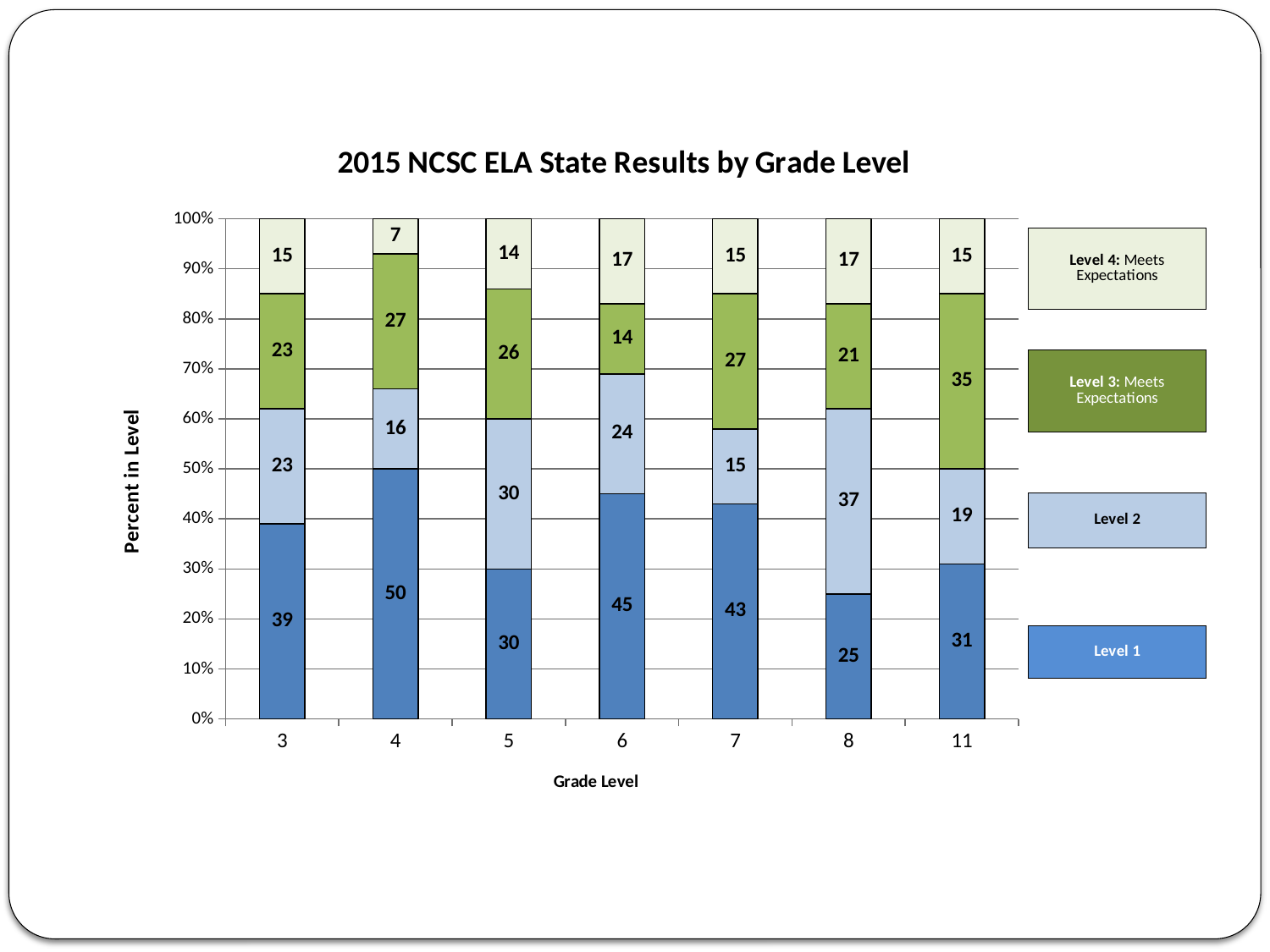
What is the title of the chart? 2015 NCSC ELA State Results by Grade Level What is the Level 1 value for grade 4? 50 Which is larger, the Level 2 value for grade 5 or the Level 2 value for grade 7? grade 5 Which grade level has the highest Level 1 value? 4 What is the Level 3 value for grade 11? 35 What is the Level 4 value for grade 6? 17 How many series does the legend list? 4 Which grade level has the lowest Level 4 value? 4 How many grade levels are shown on the x axis? 7 What is the difference between the Level 1 values for grade 6 and grade 8? 20 What kind of chart is shown? stacked bar chart What is the Level 2 value for grade 8? 37